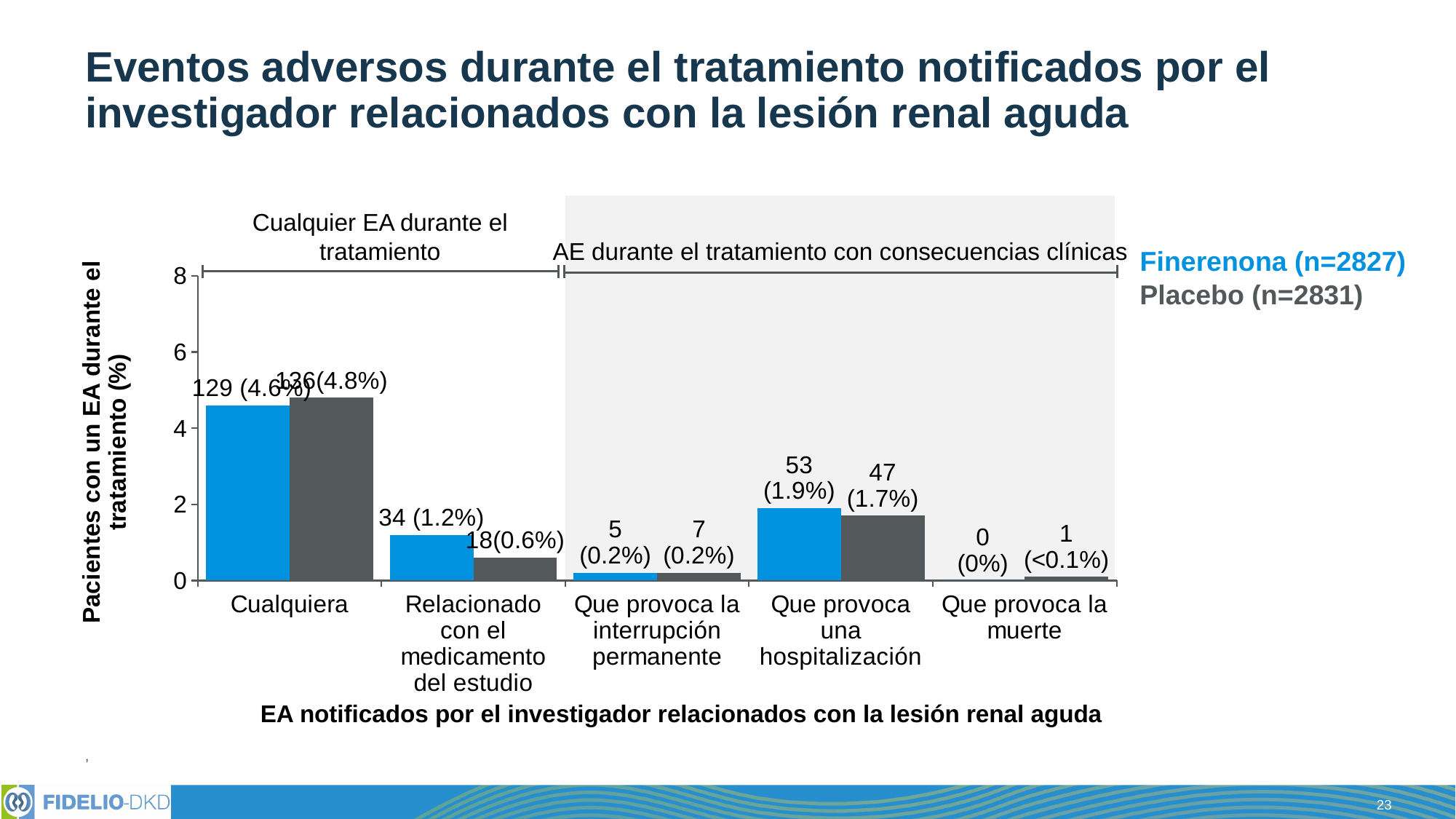
What is the value for Placebo in the 'Que provoca la muerte' category? 1 (<0.1%) How many categories are shown on the x axis? 5 What is the sample size of the Finerenona group shown in the legend? n=2827 What kind of chart is shown on the slide? bar chart What is the percentage of patients with an AE leading to hospitalization (Que provoca una hospitalización) in the Finerenona group? 1.9% Is the Placebo value for 'Cualquiera' greater or less than 4%? greater How many series does the legend list? 2 What is the difference in number of patients between Finerenona and Placebo for 'Que provoca una hospitalización'? 6 How many Placebo patients had an AE related to the study drug (Relacionado con el medicamento del estudio)? 18 In the 'Cualquiera' category, which group has the larger value, Finerenona or Placebo? Placebo Which category has the highest value for Finerenona? Cualquiera Which category has the lowest value for Finerenona? Que provoca la muerte